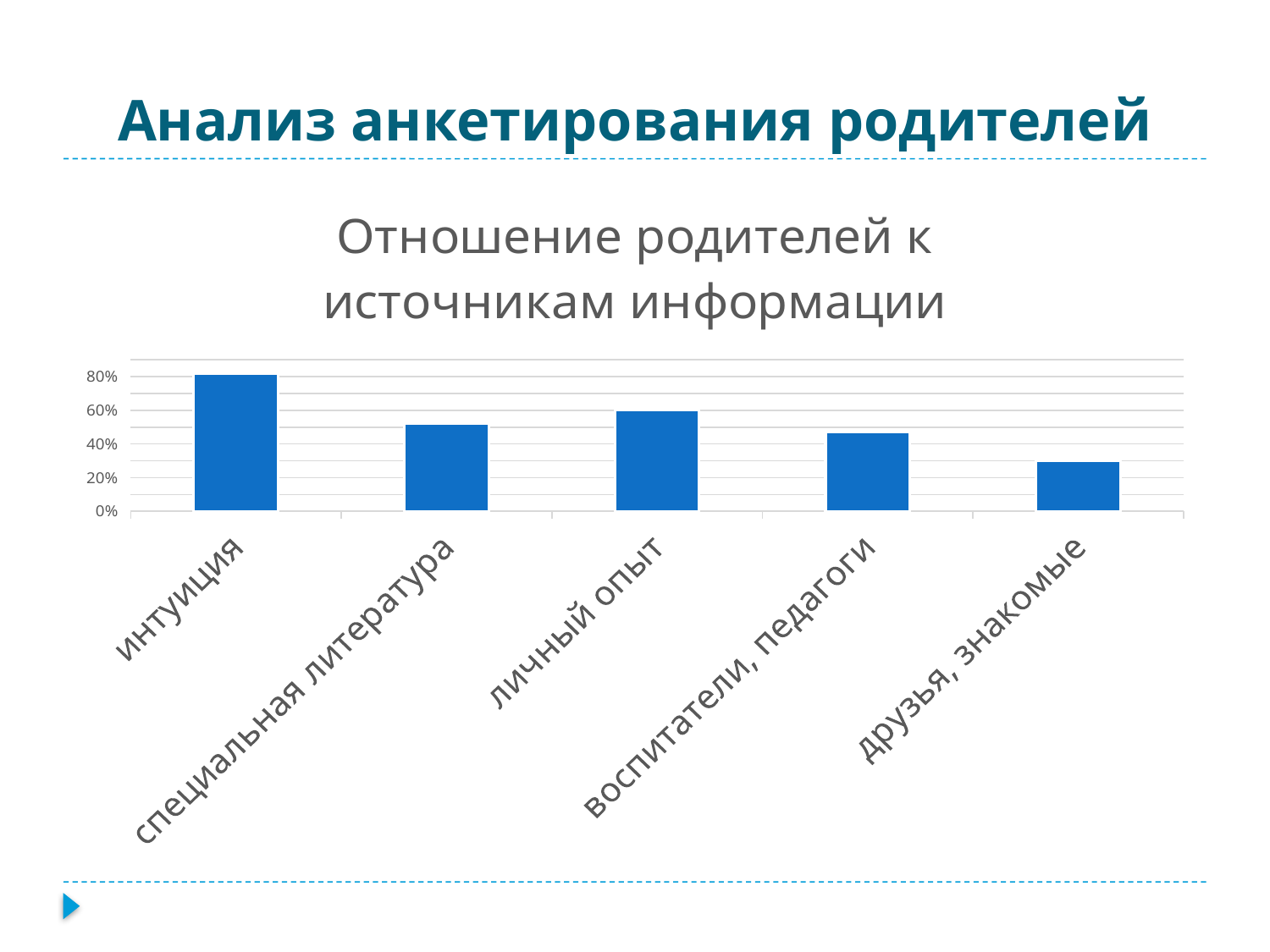
Is the value for друзья, знакомые greater or less than 40%? less Which is larger: the value for личный опыт or the value for друзья, знакомые? личный опыт Is the value for специальная литература greater or less than 40%? greater What kind of chart is shown on the slide? bar chart Is the value for воспитатели, педагоги greater or less than 60%? less What is the title of the chart? Отношение родителей к источникам информации How many categories are shown on the x axis of the chart? 5 Which category has the highest value? интуиция Which is larger: the value for интуиция or the value for личный опыт? интуиция Which category has the lowest value? друзья, знакомые